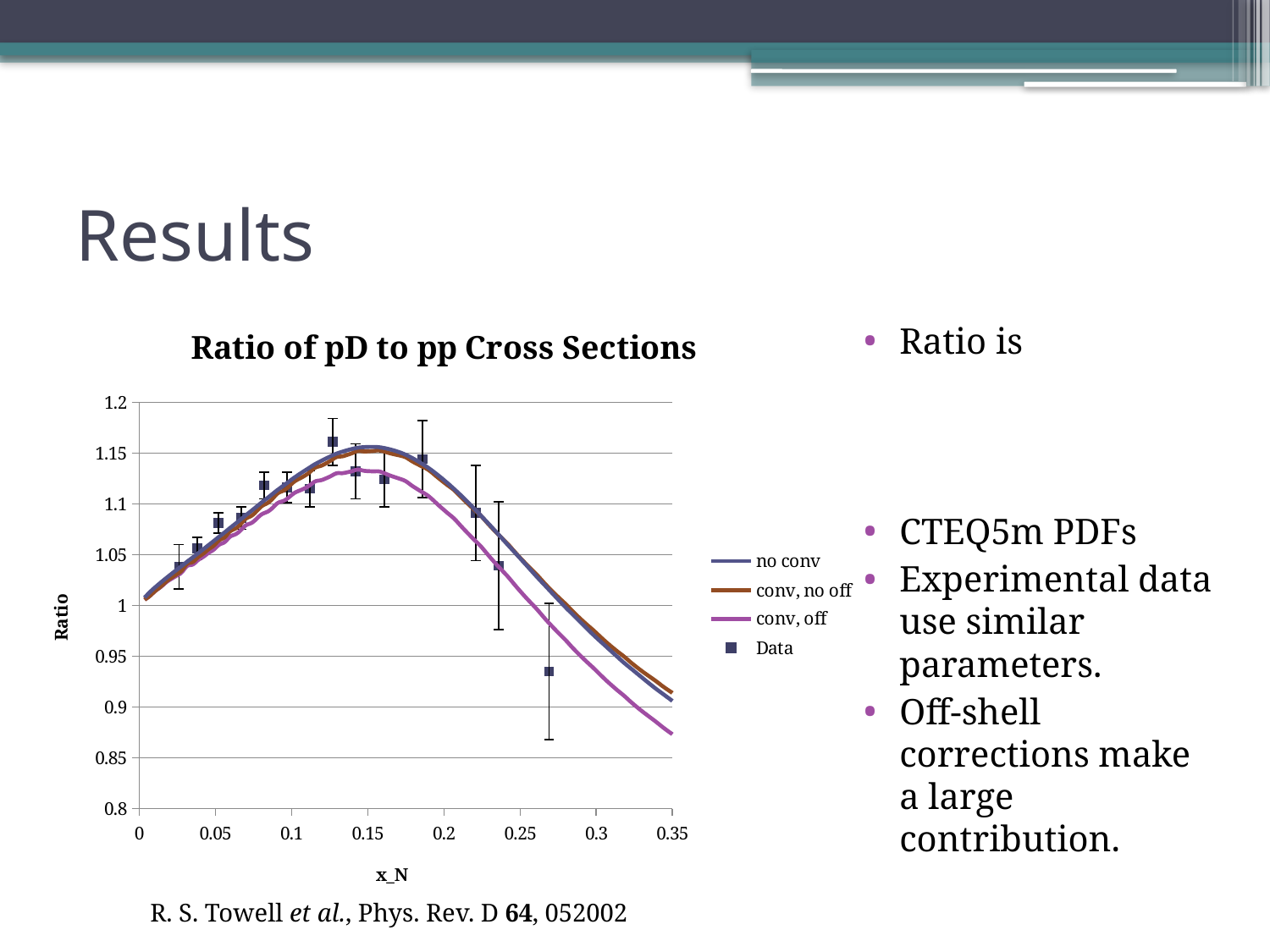
Is the value of the "conv, off" curve at x_N = 0.35 greater or less than 0.9? less Do the curves rise or fall as x_N increases from 0.2 to 0.35? fall At x_N = 0.35, which series is higher, "no conv" or "conv, off"? no conv Is the Data point near x_N = 0.27 greater or less than 1? less What is the label of the x axis of the chart? x_N Which series is the lowest of the three curves around x_N = 0.15? conv, off How many entries does the chart's legend list? 4 What kind of chart is shown on the slide? line chart Which series has the lowest value at x_N = 0.35? conv, off What is the title of the chart? Ratio of pD to pp Cross Sections Do the curves rise or fall as x_N increases from 0 to 0.1? rise Is the peak value of the "conv, off" curve greater or less than 1.15? less